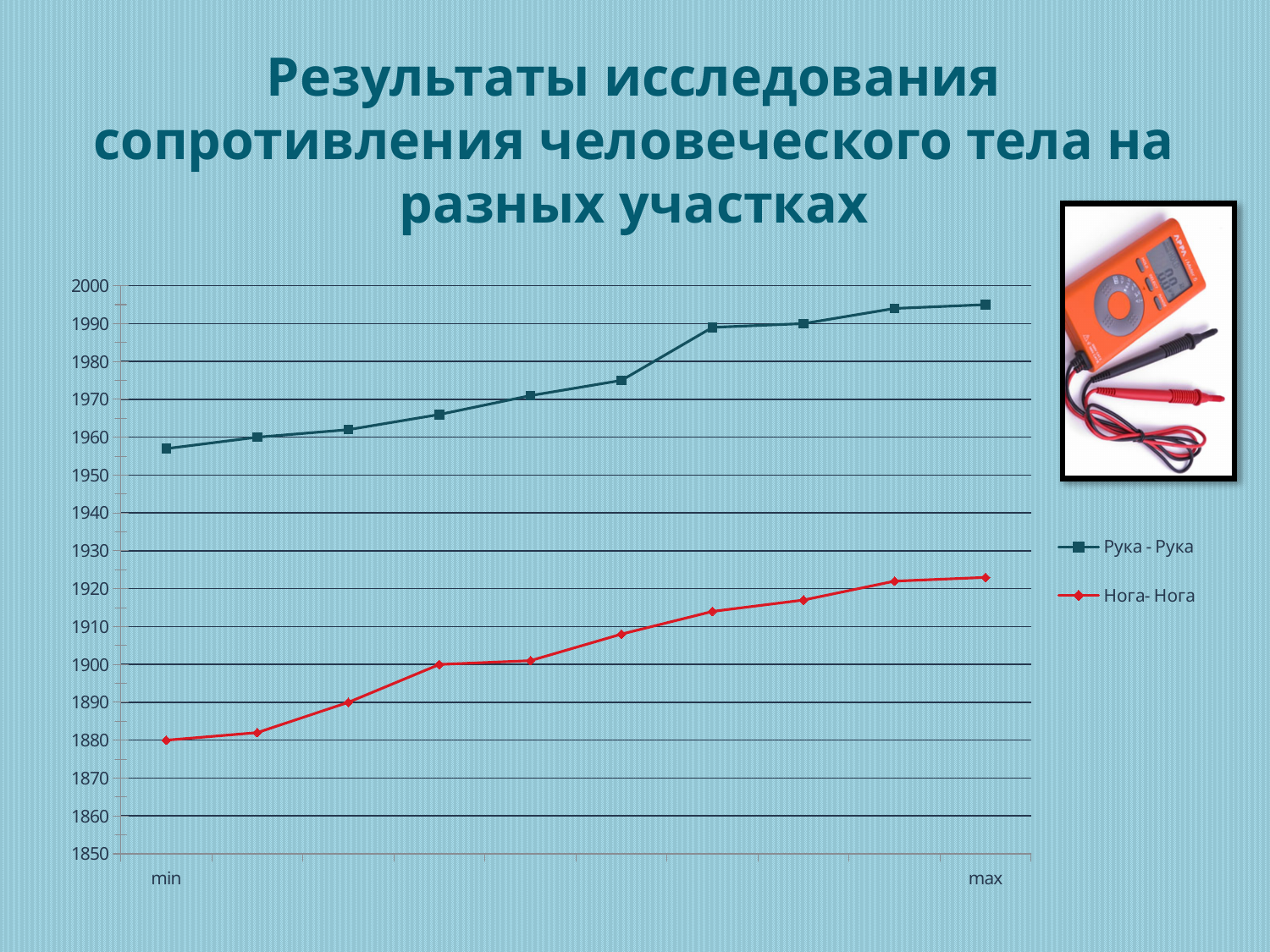
Do the values of the Нога- Нога series rise or fall from min to max along the x axis? rise How many data points does the Рука - Рука series have? 10 Is the value for Нога- Нога at min greater or less than 1890? less What labels are shown at the two ends of the x axis? min and max What kind of chart is shown on the slide? line chart Is the value for Рука - Рука at min greater or less than 1950? greater Is the value for Рука - Рука at max greater or less than 1990? greater How many series does the legend list? 2 At max, which series has the higher value, Рука - Рука or Нога- Нога? Рука - Рука What are the two series named in the legend? Рука - Рука and Нога- Нога Do the values of the Рука - Рука series rise or fall from min to max along the x axis? rise